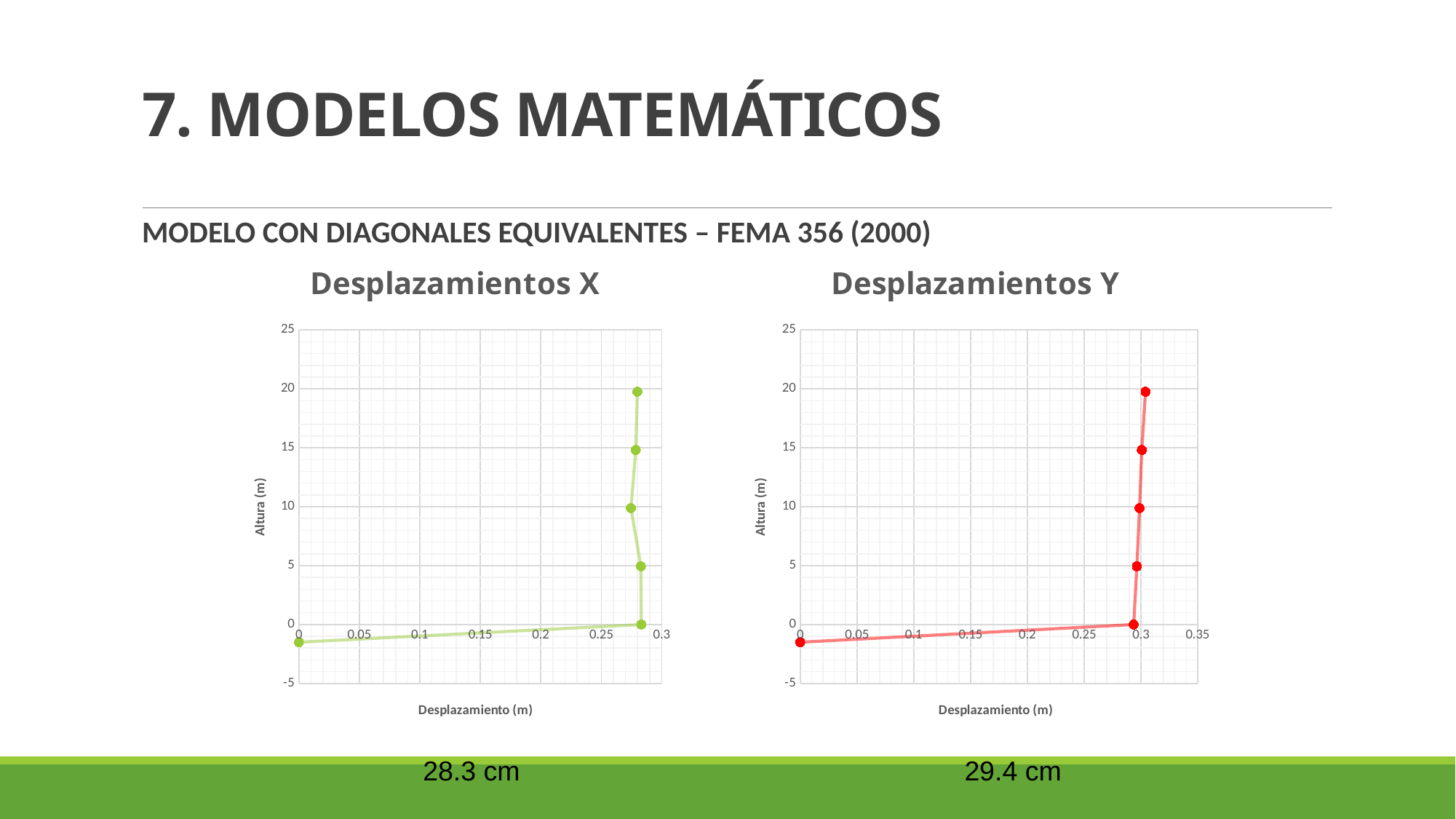
What is the x-axis title of the "Desplazamientos X" chart? Desplazamiento (m) How many data points are plotted in the "Desplazamientos X" chart? 6 How many data points are plotted in the "Desplazamientos Y" chart? 6 In the "Desplazamientos Y" chart, is the displacement of the highest point (near 20 m altura) greater or less than 0.25? greater In the "Desplazamientos Y" chart, is the displacement of the point at about 5 m altura greater or less than 0.2? greater In the "Desplazamientos Y" chart, is the displacement of the point at about 10 m altura greater or less than 0.35? less What is the highest tick value shown on the x axis of the "Desplazamientos Y" chart? 0.35 In the "Desplazamientos X" chart, does the displacement generally increase or decrease as altura rises from the lowest point to the point at about 5 m? increase What kind of chart is "Desplazamientos X"? Scatter chart with lines